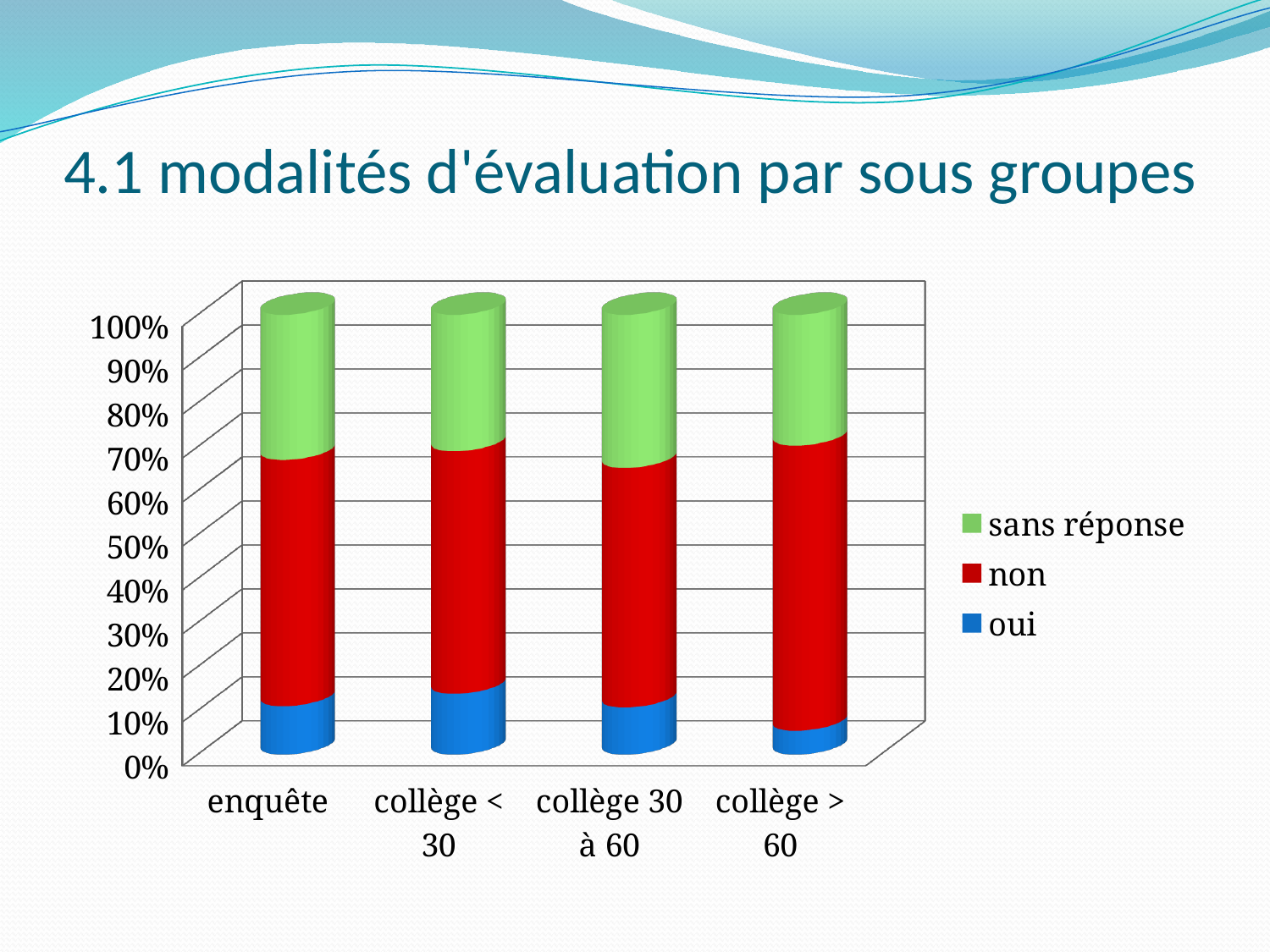
What kind of chart is shown on the slide? bar chart How many categories are shown on the x axis of the chart? 4 Is the 'oui' value for collège > 60 greater or less than 10%? less Which series is shown in blue in the chart? oui Which is larger: the 'oui' segment for collège < 30 or for collège > 60? collège < 30 What is the title of the chart on the slide? 4.1 modalités d'évaluation par sous groupes How many series does the chart legend list? 3 Which category has the largest 'oui' segment? collège < 30 What is the total height of the stacked bar for enquête? 100% Which category has the smallest 'sans réponse' segment? collège > 60 Is the 'oui' value for collège < 30 greater or less than 10%? greater Which category has the smallest 'oui' segment? collège > 60